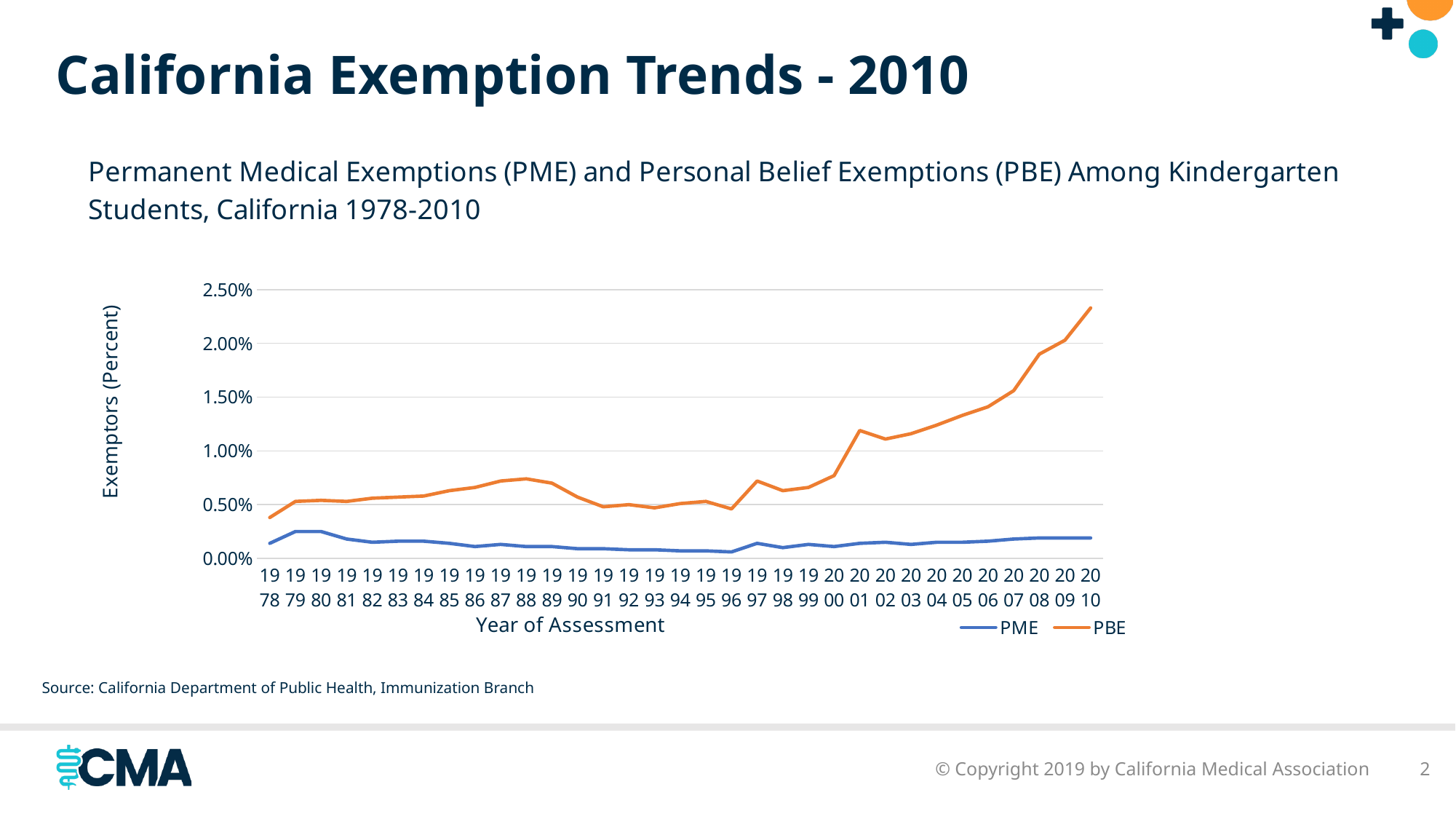
Is the PBE value for 2010 greater or less than 2.00%? greater How many years of assessment are plotted along the x axis? 33 What kind of chart is shown on the slide? Line chart In which year does the PBE series reach its highest value? 2010 Is the PBE value for 1988 greater or less than 0.50%? greater Does the PBE series rise or fall from 2002 to 2010? Rise How many series does the legend list? 2 What colour is the PBE line in the chart? Orange Is the PME value for 1979 greater or less than 0.50%? less In which year is the PBE series at its lowest value? 1978 Which series has the higher value in 2010, PME or PBE? PBE